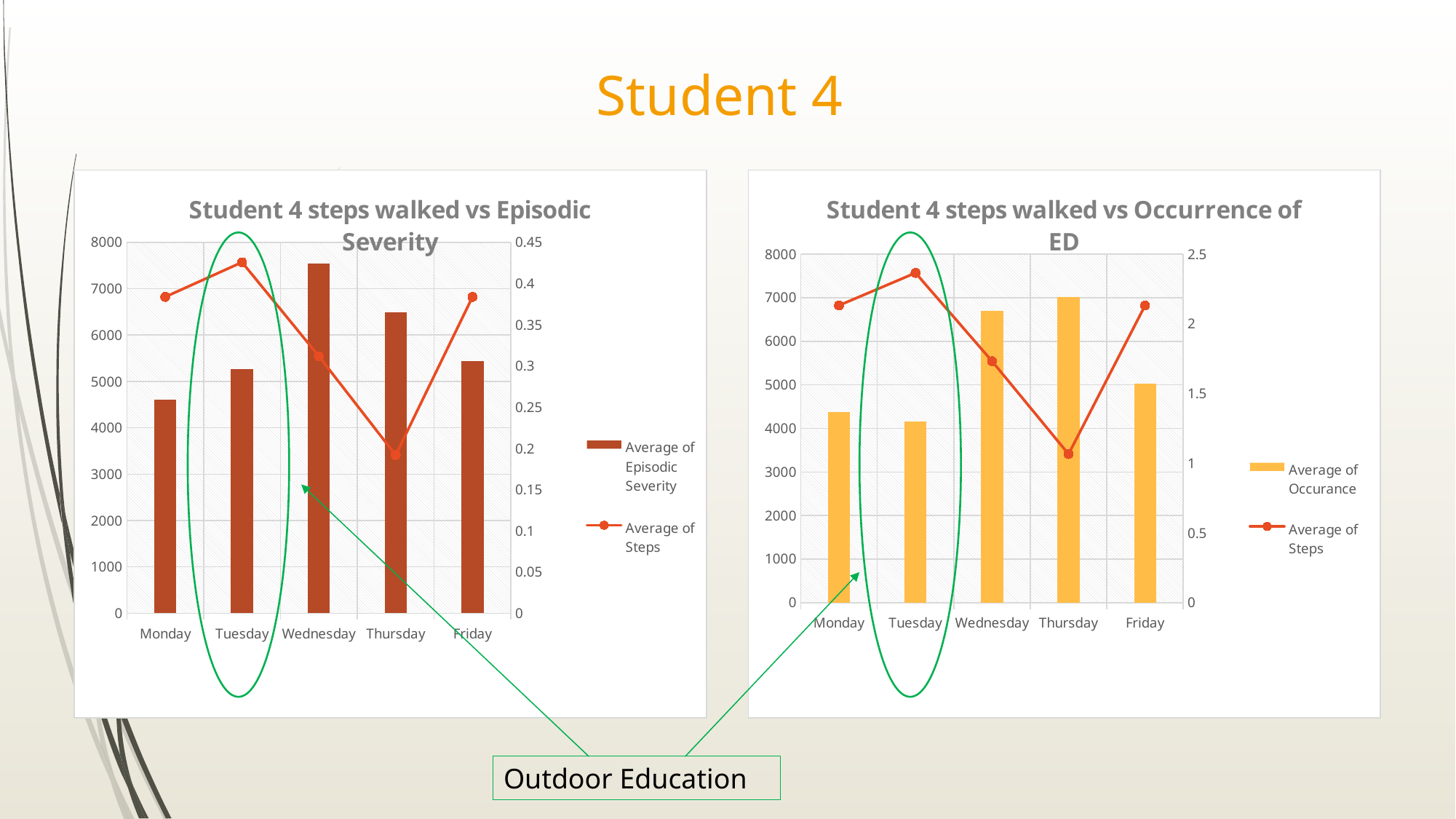
In the chart titled 'Student 4 steps walked vs Episodic Severity', is the Average of Episodic Severity bar taller for Thursday or for Friday? Thursday In the chart titled 'Student 4 steps walked vs Occurrence of ED', on which day does the Average of Steps line reach its lowest point? Thursday In the chart titled 'Student 4 steps walked vs Occurrence of ED', which day has the shortest bar for Average of Occurance? Tuesday How many series does the legend list in the chart titled 'Student 4 steps walked vs Episodic Severity'? 2 In the chart titled 'Student 4 steps walked vs Occurrence of ED', which day has the tallest bar for Average of Occurance? Thursday In the chart titled 'Student 4 steps walked vs Episodic Severity', on which day does the Average of Steps line reach its lowest point? Thursday How many days are shown on the x axis of the chart titled 'Student 4 steps walked vs Occurrence of ED'? 5 In the chart titled 'Student 4 steps walked vs Episodic Severity', on which day does the Average of Steps line reach its highest point? Tuesday In the chart titled 'Student 4 steps walked vs Occurrence of ED', is the Average of Occurance bar taller for Wednesday or for Friday? Wednesday In the chart titled 'Student 4 steps walked vs Occurrence of ED', does the Average of Steps line rise or fall from Thursday to Friday? rise In the chart titled 'Student 4 steps walked vs Episodic Severity', which day has the tallest bar for Average of Episodic Severity? Wednesday